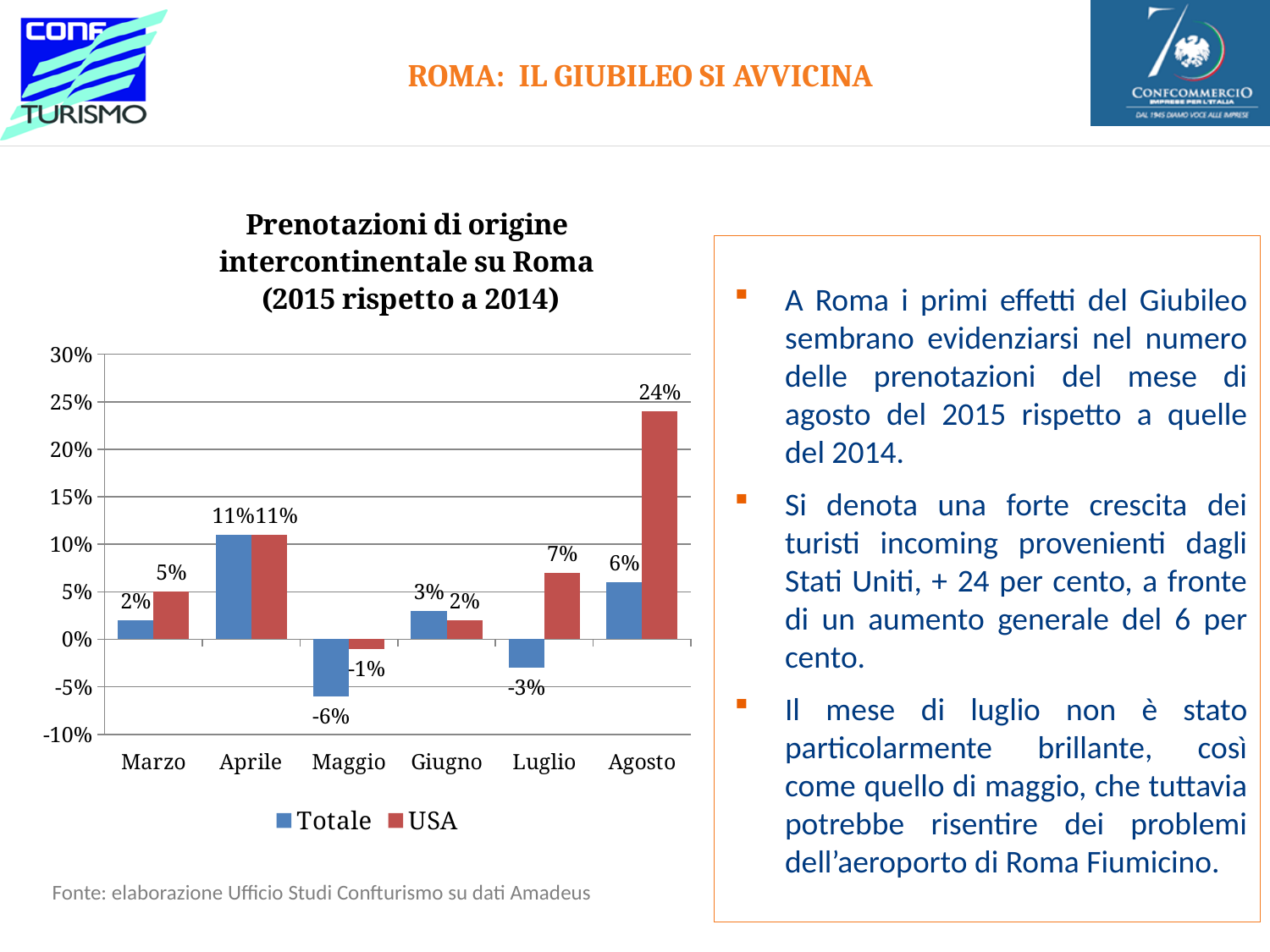
Which month has the highest USA value? Agosto What is the USA value for Marzo? 5% How many series does the legend list? 2 How many months are shown on the x axis? 6 For Giugno, which series has the larger value, Totale or USA? Totale What is the Totale value for Maggio? -6% What kind of chart is shown on the slide? Bar chart What is the USA value for Agosto? 24% What is the Totale value for Luglio? -3% What is the title of the chart? Prenotazioni di origine intercontinentale su Roma (2015 rispetto a 2014) Which month has the lowest Totale value? Maggio What is the difference between the USA and Totale values for Agosto? 18%